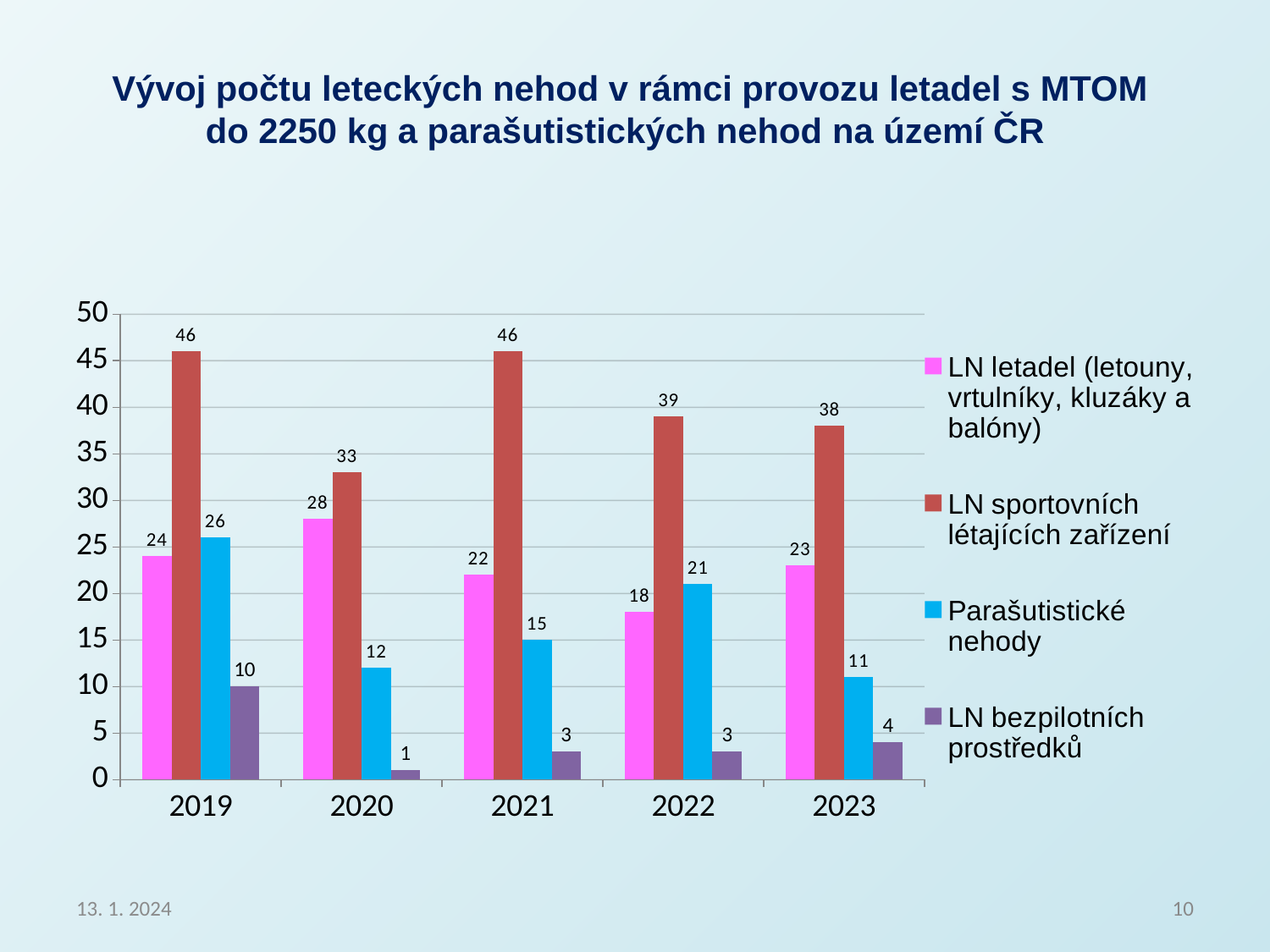
How many series does the legend list? 4 In which year is the value for LN letadel (letouny, vrtulníky, kluzáky a balóny) highest? 2020 What is the value for LN sportovních létajících zařízení in 2021? 46 Which colour represents Parašutistické nehody in the legend? Blue Does the value for LN bezpilotních prostředků rise or fall from 2019 to 2020? Fall What kind of chart is shown on the slide? Bar chart What is the value for LN bezpilotních prostředků in 2020? 1 What is the difference between LN sportovních létajících zařízení and LN letadel (letouny, vrtulníky, kluzáky a balóny) in 2019? 22 In which year is the value for Parašutistické nehody lowest? 2023 What is the value for Parašutistické nehody in 2022? 21 How many years are shown on the x axis? 5 Which is larger in 2023: Parašutistické nehody or LN letadel (letouny, vrtulníky, kluzáky a balóny)? LN letadel (letouny, vrtulníky, kluzáky a balóny)